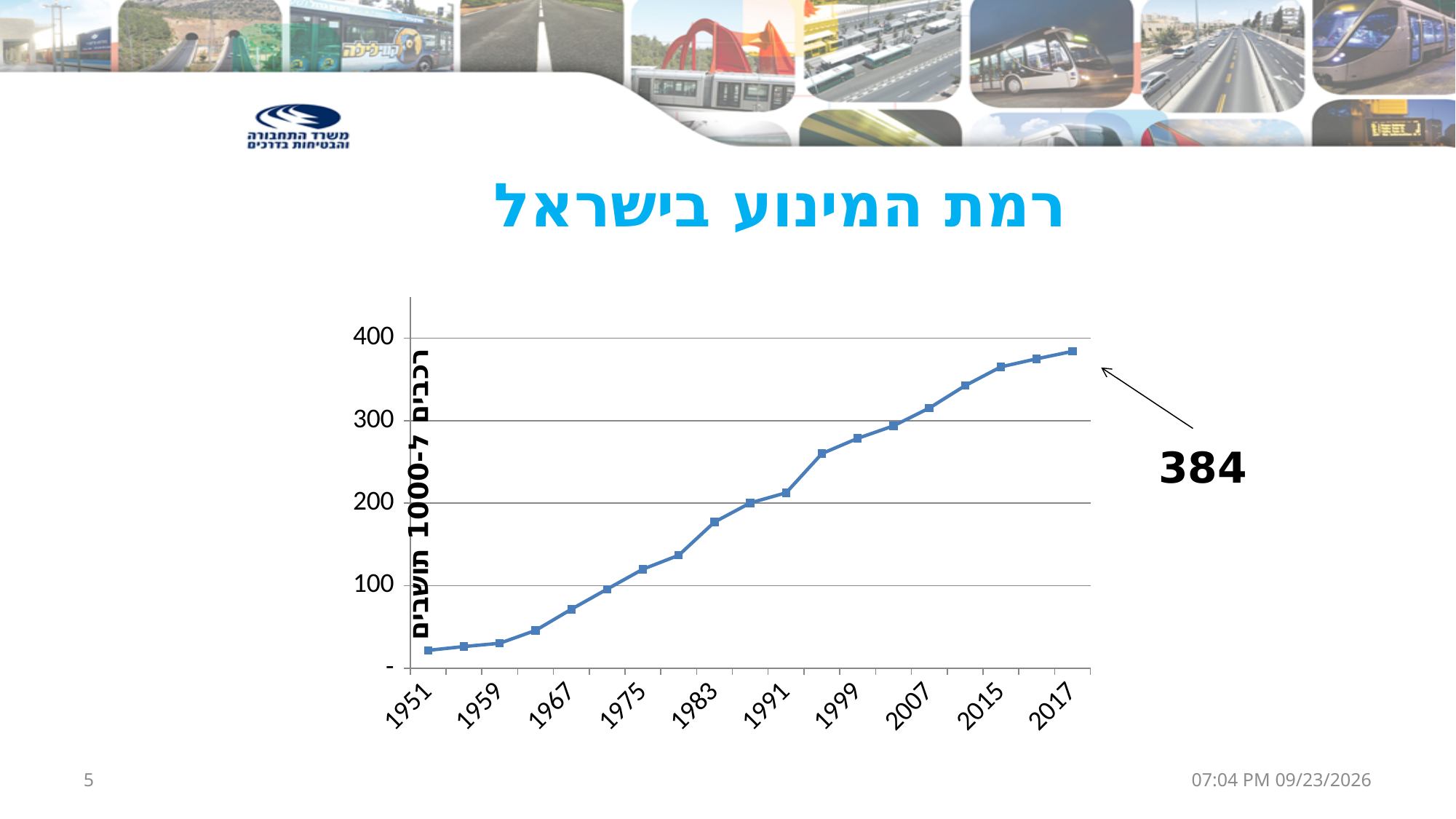
Which is larger, the value for 1983 or the value for 1999? 1999 Is the value for 1975 greater or less than 200? less Which year has the highest value on the chart? 2017 Is the value for 1951 greater or less than 100? less How many year labels are shown on the x axis? 10 Is the value for 1991 greater or less than 300? less What is the value for 2017, as annotated on the chart? 384 Do the values rise or fall from 1951 to 2017? rise What is the title of the chart on the slide? רמת המינוע בישראל Which year has the lowest value on the chart? 1951 What kind of chart is shown on the slide? line chart